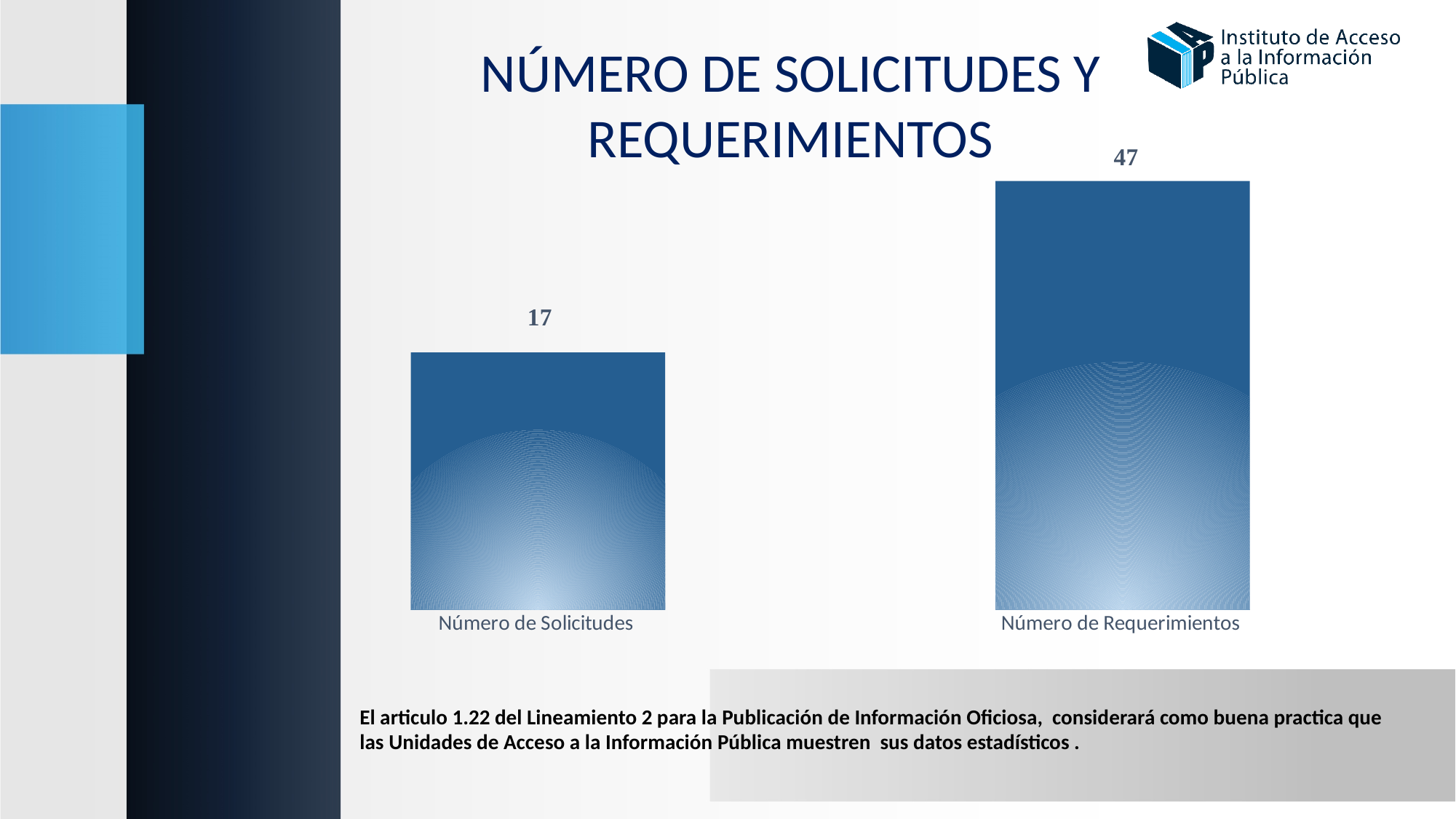
What is the difference between Número de Requerimientos and Número de Solicitudes? 30 Which category has the highest value? Número de Requerimientos What kind of chart is shown on the slide? Bar chart How many categories are shown in the chart? 2 Which is larger, Número de Solicitudes or Número de Requerimientos? Número de Requerimientos Which category has the lowest value? Número de Solicitudes Do the values rise or fall from left to right across the categories? Rise What is the value for Número de Requerimientos? 47 What is the total of the two values shown in the chart? 64 What is the value for Número de Solicitudes? 17 What is the title of the slide containing the chart? NÚMERO DE SOLICITUDES Y REQUERIMIENTOS What colour are the bars in the chart? Blue